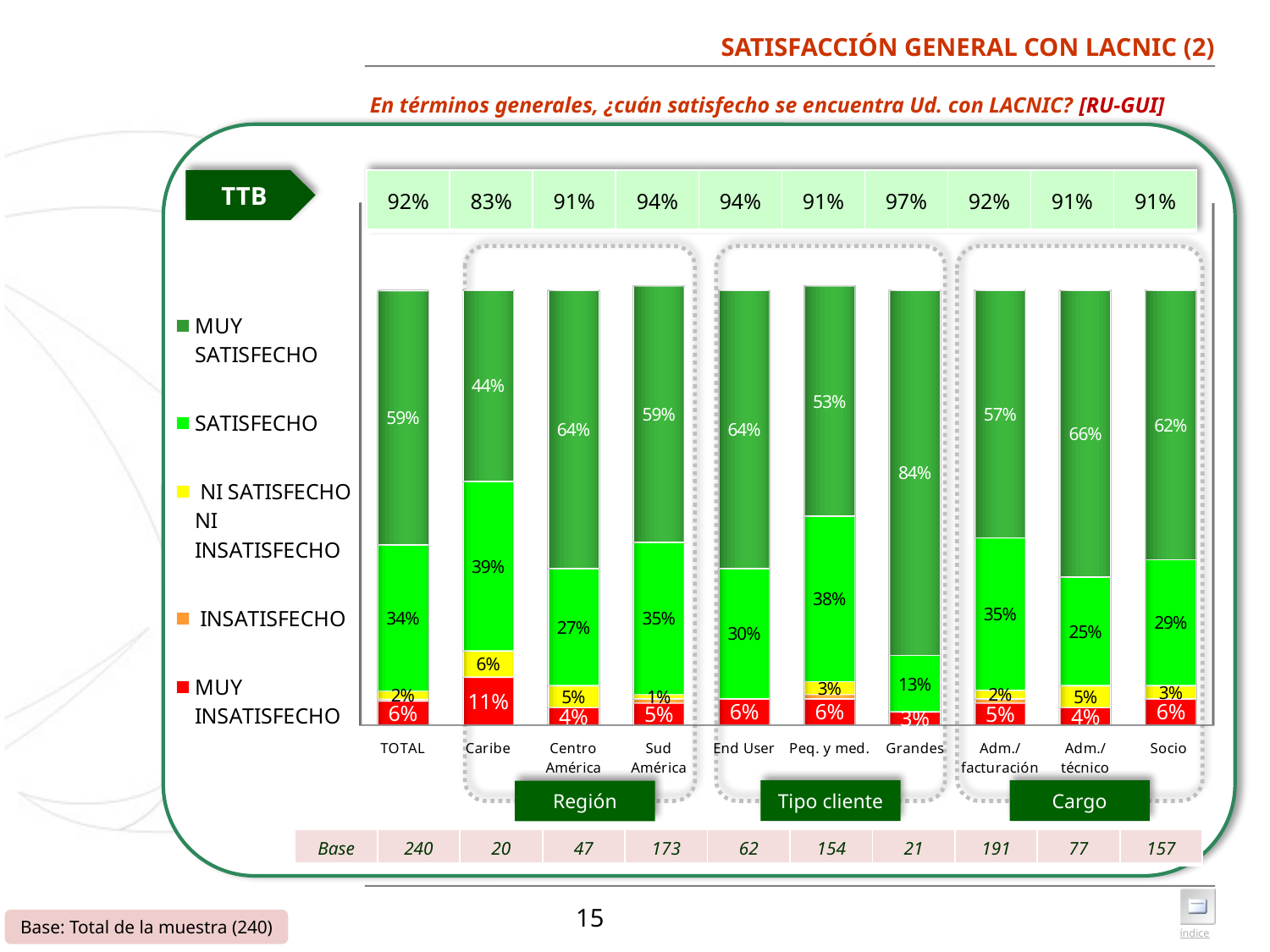
How many categories (bars) are plotted along the x axis? 10 Which is larger, the SATISFECHO value for End User or for Peq. y med.? Peq. y med. What is the MUY SATISFECHO value for Grandes? 84% What is the SATISFECHO value for Caribe? 39% What type of chart is shown on the slide? Stacked bar chart Which category has the highest MUY SATISFECHO value? Grandes What is the TTB value shown for Sud América? 94% Which category has the lowest SATISFECHO value? Grandes What is the Base shown for Centro América? 47 What is the difference between the MUY SATISFECHO values for Adm./técnico and Adm./facturación? 9% How many series does the legend list? 5 What is the MUY INSATISFECHO value for Caribe? 11%